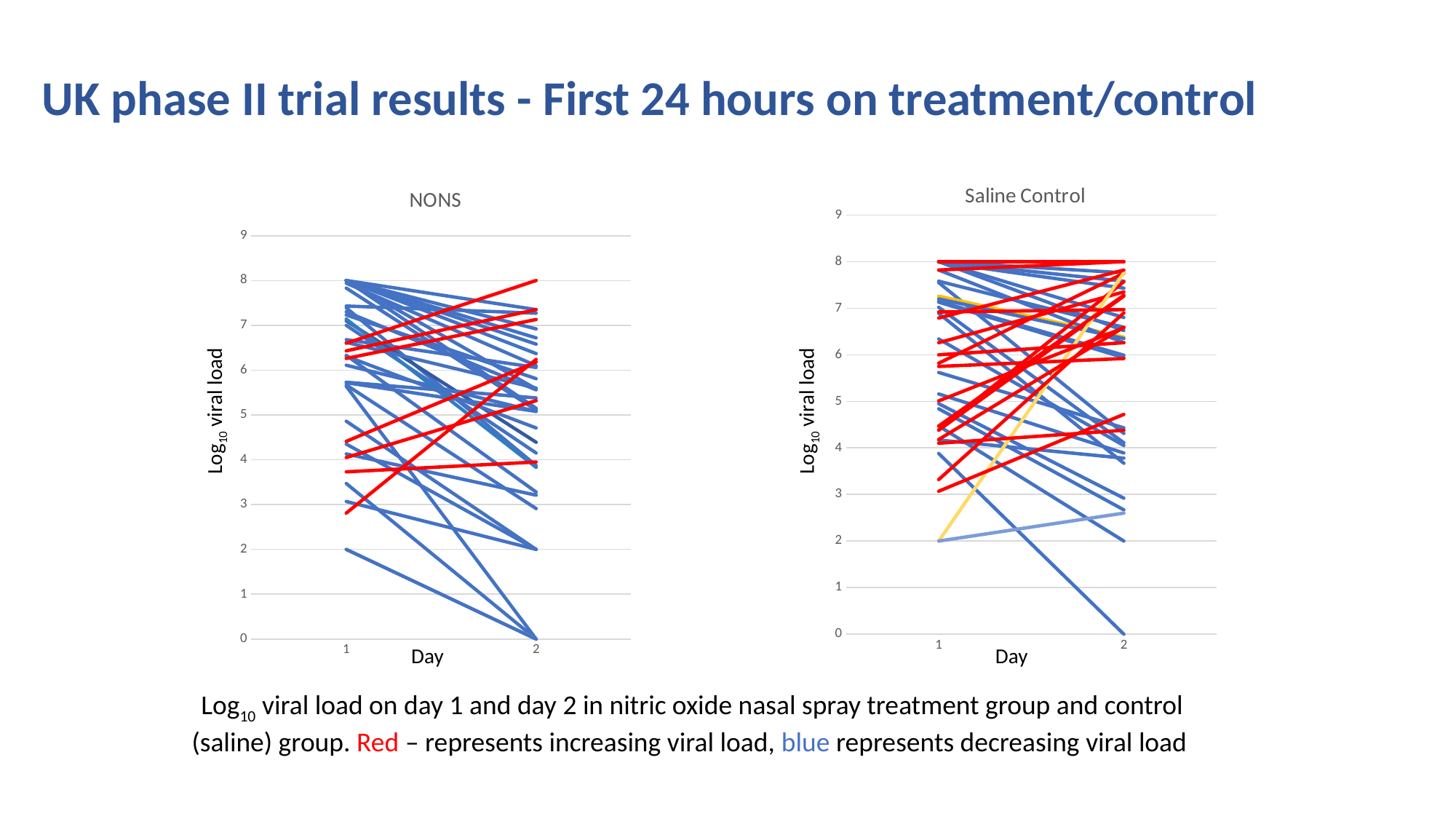
In the NONS chart, is the lowest day 2 value greater or less than 1? less What kind of chart is the Saline Control chart? line chart In the Saline Control chart, is the lowest day 2 value greater or less than 1? less What kind of chart is the NONS chart? line chart According to the slide, what do the red lines represent? increasing viral load In the Saline Control chart, is the highest day 1 value greater or less than 7? greater In the NONS chart, do most of the lines rise or fall from day 1 to day 2? fall How many days are shown on the x axis of the NONS chart? 2 How many points are on the x axis of the Saline Control chart? 2 What is the highest tick shown on the y axis of the NONS chart? 9